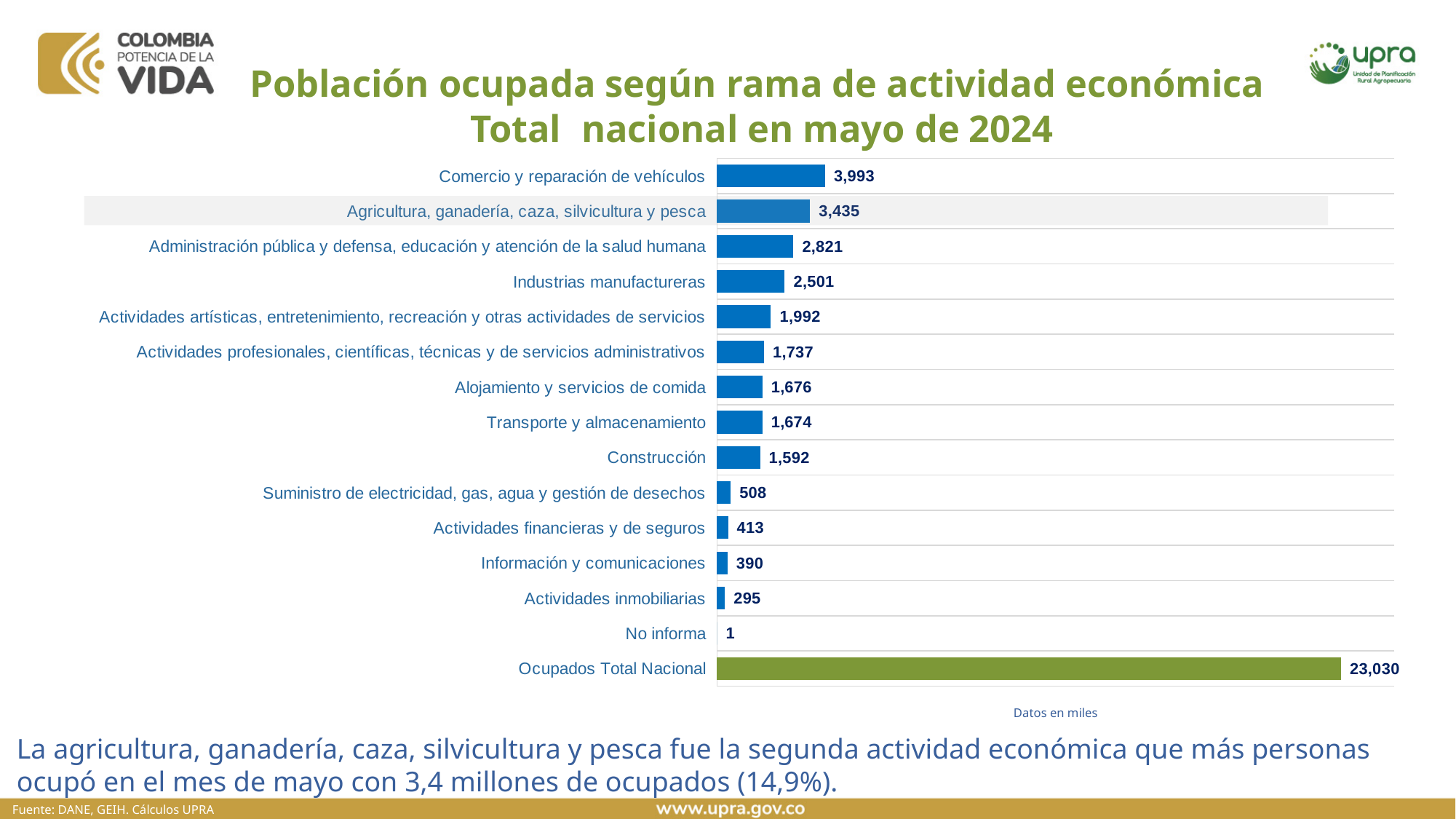
Which category has the lowest value? No informa What is the value for Ocupados Total Nacional? 23,030 What is the value for Industrias manufactureras? 2,501 What is the value for Actividades inmobiliarias? 295 What is the difference between the values for Suministro de electricidad, gas, agua y gestión de desechos and Actividades financieras y de seguros? 95 What kind of chart is shown on the slide? Bar chart Excluding the Ocupados Total Nacional bar, which category has the highest value? Comercio y reparación de vehículos What is the difference between the values for Comercio y reparación de vehículos and Agricultura, ganadería, caza, silvicultura y pesca? 558 Which is larger, the value for Construcción or the value for Información y comunicaciones? Construcción What unit note is printed below the chart? Datos en miles What is the value for Agricultura, ganadería, caza, silvicultura y pesca? 3,435 How many bars are shown in the chart? 15